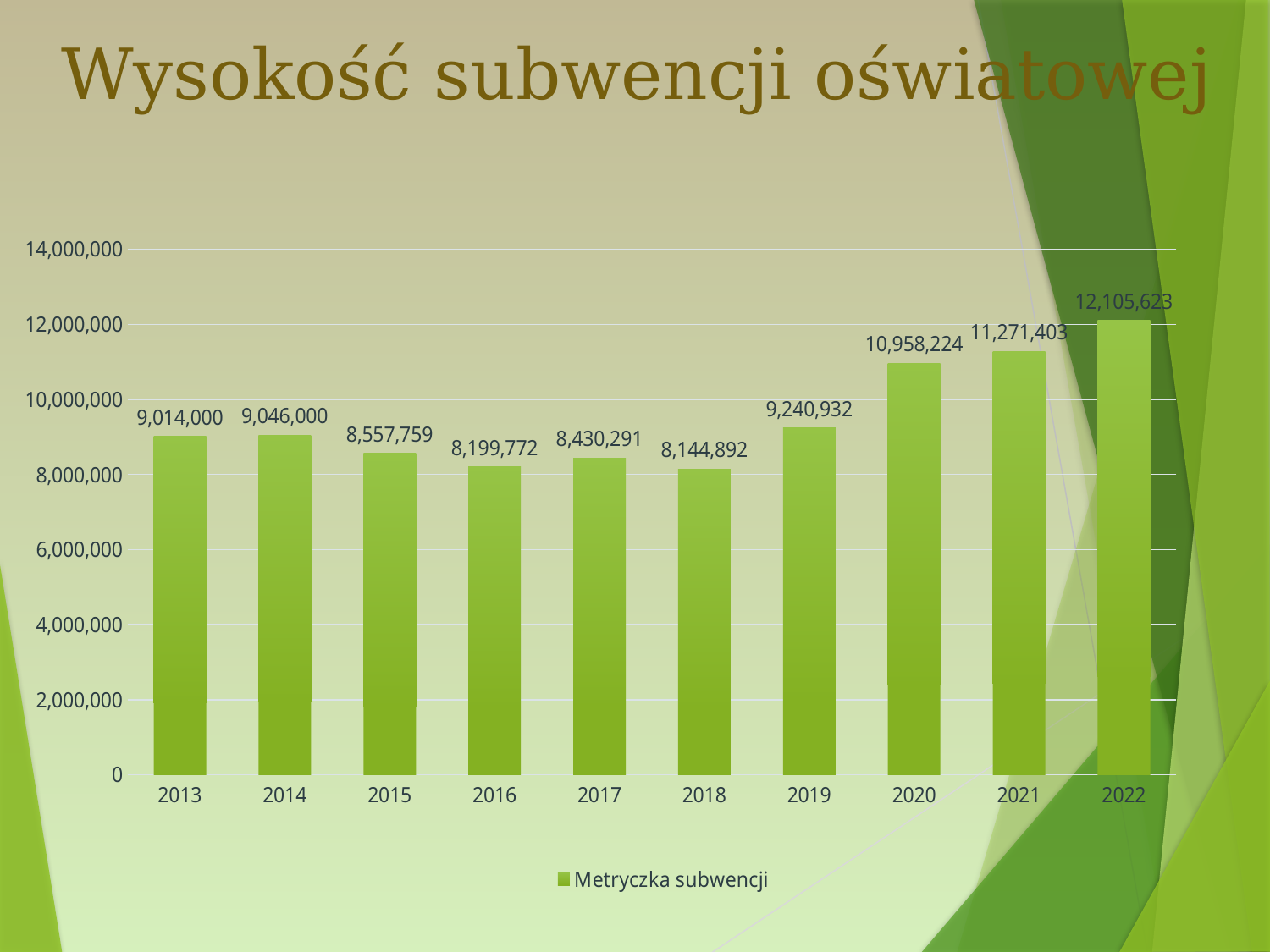
What is the difference between the values for 2014 and 2013? 32,000 What is the value for 2013? 9,014,000 What is the value for 2022? 12,105,623 Which year has the highest value? 2022 Which year has the lowest value? 2018 How many years are shown on the x axis? 10 What is the value for 2018? 8,144,892 Which is larger, the value for 2017 or the value for 2016? 2017 What is the difference between the values for 2022 and 2021? 834,220 What kind of chart is shown? bar chart What is the name of the series in the legend? Metryczka subwencji Is the value for 2020 greater or less than 10,000,000? greater